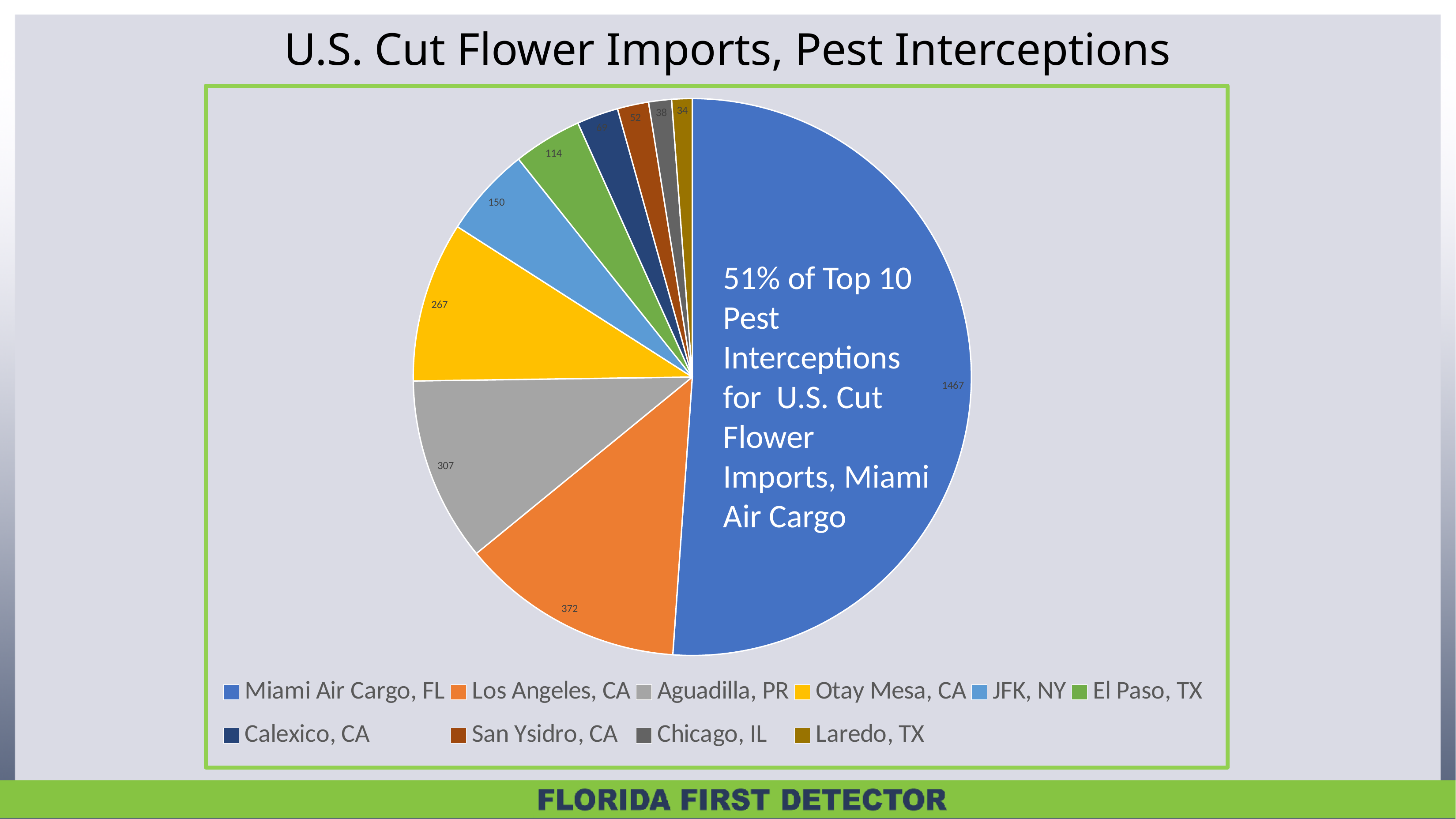
According to the slide, what share of the top 10 pest interceptions does Miami Air Cargo account for? 51% What kind of chart is shown on the slide? pie chart What is the value for Aguadilla, PR? 307 What is the difference between the values for Los Angeles, CA and Aguadilla, PR? 65 What is the value for JFK, NY? 150 What is the value for Laredo, TX? 34 How many pest interceptions are shown for Miami Air Cargo, FL? 1467 What is the value for Otay Mesa, CA? 267 How many ports (slices) are shown in the pie chart? 10 What is the value for Los Angeles, CA? 372 Which port has the largest slice of the pie? Miami Air Cargo, FL Which port has the smallest slice of the pie? Laredo, TX